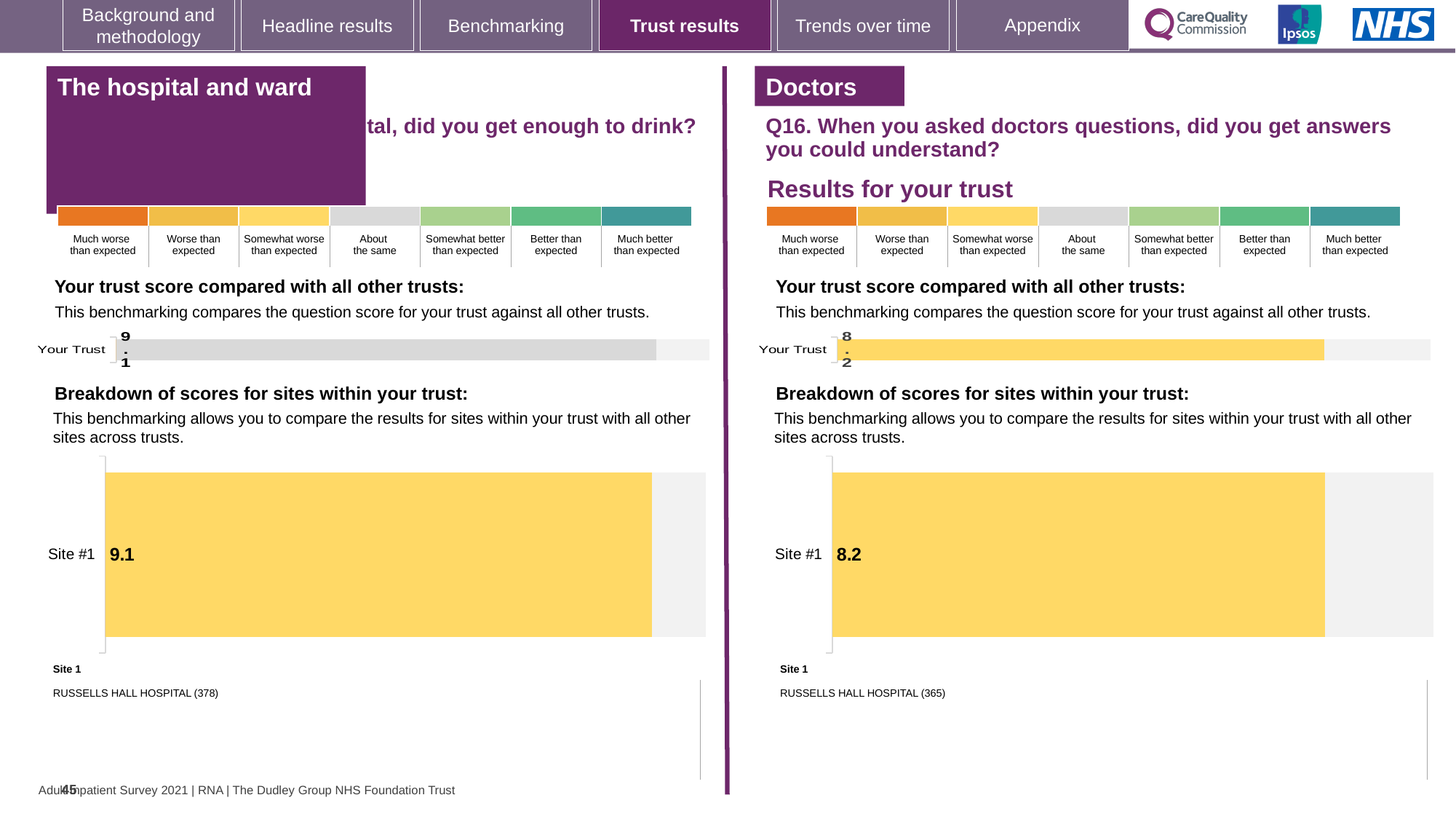
Is the Your Trust score in the right-hand (Q16) chart greater or less than the Your Trust score in the left-hand chart? Less How many sites are shown in the right-hand 'Breakdown of scores for sites within your trust' chart? 1 In the left-hand 'Breakdown of scores for sites within your trust' chart, what is the score for Site #1? 9.1 Which site name is listed under Site 1 for the right-hand (Q16) breakdown chart? RUSSELLS HALL HOSPITAL (365) What is the difference between the Site #1 score in the left-hand breakdown chart (9.1) and the Site #1 score in the right-hand breakdown chart (8.2)? 0.9 What colour is the Site #1 bar in the left-hand 'Breakdown of scores for sites within your trust' chart? Yellow In the right-hand 'Breakdown of scores for sites within your trust' chart (Q16), what is the score for Site #1? 8.2 Which is larger: the Site #1 score in the left-hand breakdown chart or the Site #1 score in the right-hand breakdown chart? The left-hand chart (9.1) On the right-hand side of the slide (Q16, Doctors), what is the score shown for Your Trust in the 'Your trust score compared with all other trusts' chart? 8.2 How many sites are shown in the left-hand 'Breakdown of scores for sites within your trust' chart? 1 On the left-hand side of the slide, what is the score shown for Your Trust in the 'Your trust score compared with all other trusts' chart? 9.1 What kind of chart is used to show the Site #1 score in the right-hand 'Breakdown of scores for sites within your trust' section? Bar chart